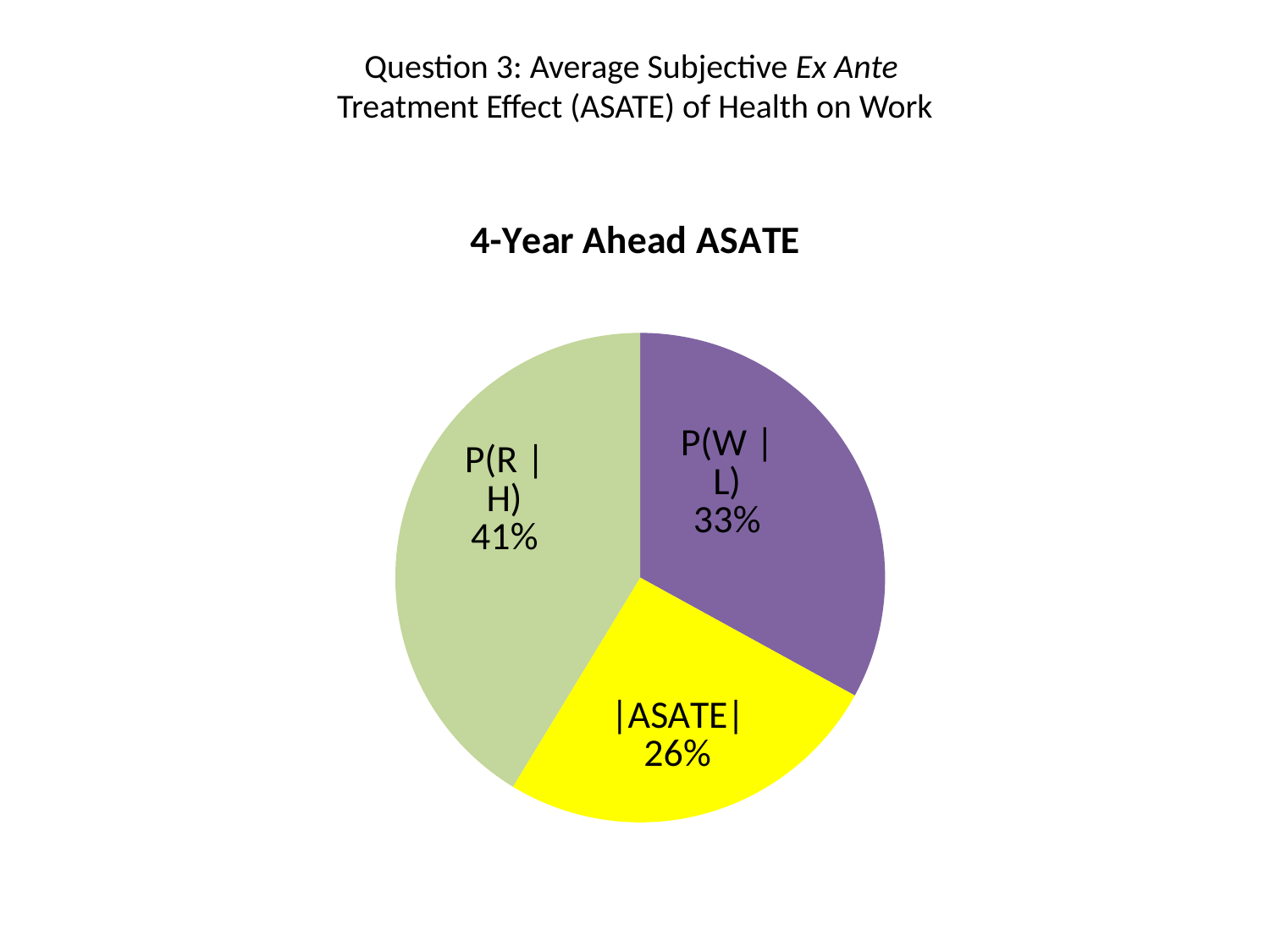
What colour is the |ASATE| slice? yellow What share of the pie is |ASATE|? 26% What is the difference in percentage points between P(R | H) and |ASATE|? 15 What is the difference in percentage points between P(W | L) and |ASATE|? 7 Which slice is the largest? P(R | H) Which slice is the smallest? |ASATE| Which is larger, P(W | L) or |ASATE|? P(W | L) What is the title of the chart? 4-Year Ahead ASATE What share of the pie is P(W | L)? 33% What type of chart is shown on the slide? pie chart How many slices does the pie chart have? 3 What share of the pie is P(R | H)? 41%